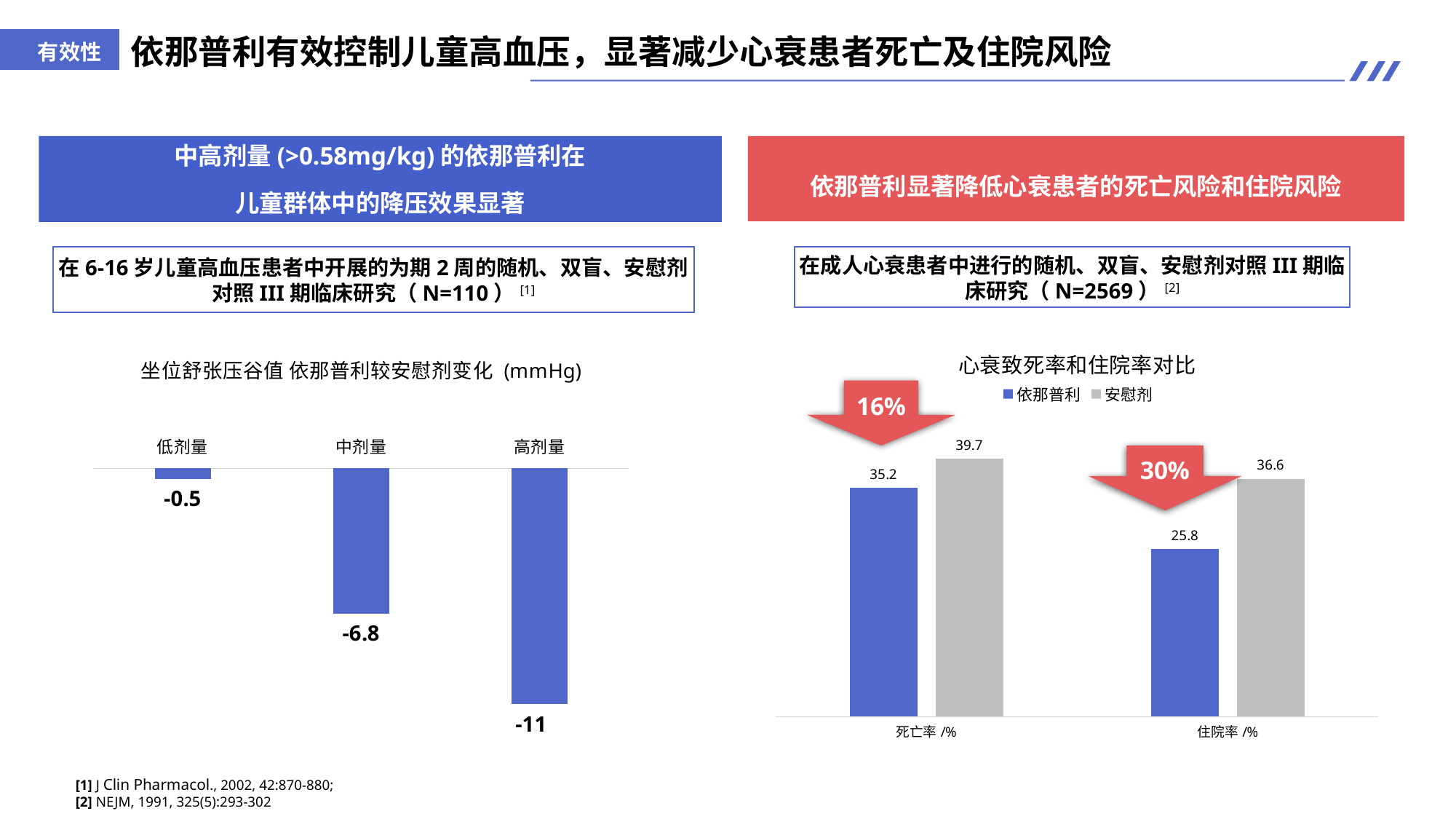
In the right chart (心衰致死率和住院率对比), what is the difference in 住院率 between 安慰剂 and 依那普利? 10.8 In the left chart (坐位舒张压谷值 依那普利较安慰剂变化), how many dose categories are shown? 3 In the right chart (心衰致死率和住院率对比), which series has the higher 死亡率, 依那普利 or 安慰剂? 安慰剂 In the left chart (坐位舒张压谷值 依那普利较安慰剂变化), what is the value for 中剂量? -6.8 In the right chart (心衰致死率和住院率对比), what is the 死亡率 for 依那普利? 35.2 In the left chart (坐位舒张压谷值 依那普利较安慰剂变化), do the values become more negative from 低剂量 to 高剂量? Yes In the left chart (坐位舒张压谷值 依那普利较安慰剂变化), which dose group shows the largest reduction? 高剂量 In the right chart (心衰致死率和住院率对比), how many series does the legend list? 2 In the right chart (心衰致死率和住院率对比), what is the 住院率 for 安慰剂? 36.6 In the left chart (坐位舒张压谷值 依那普利较安慰剂变化), what is the value for 高剂量? -11 In the left chart (坐位舒张压谷值 依那普利较安慰剂变化), what is the difference between the 高剂量 and 低剂量 values? 10.5 What type of chart is the right chart (心衰致死率和住院率对比)? Bar chart